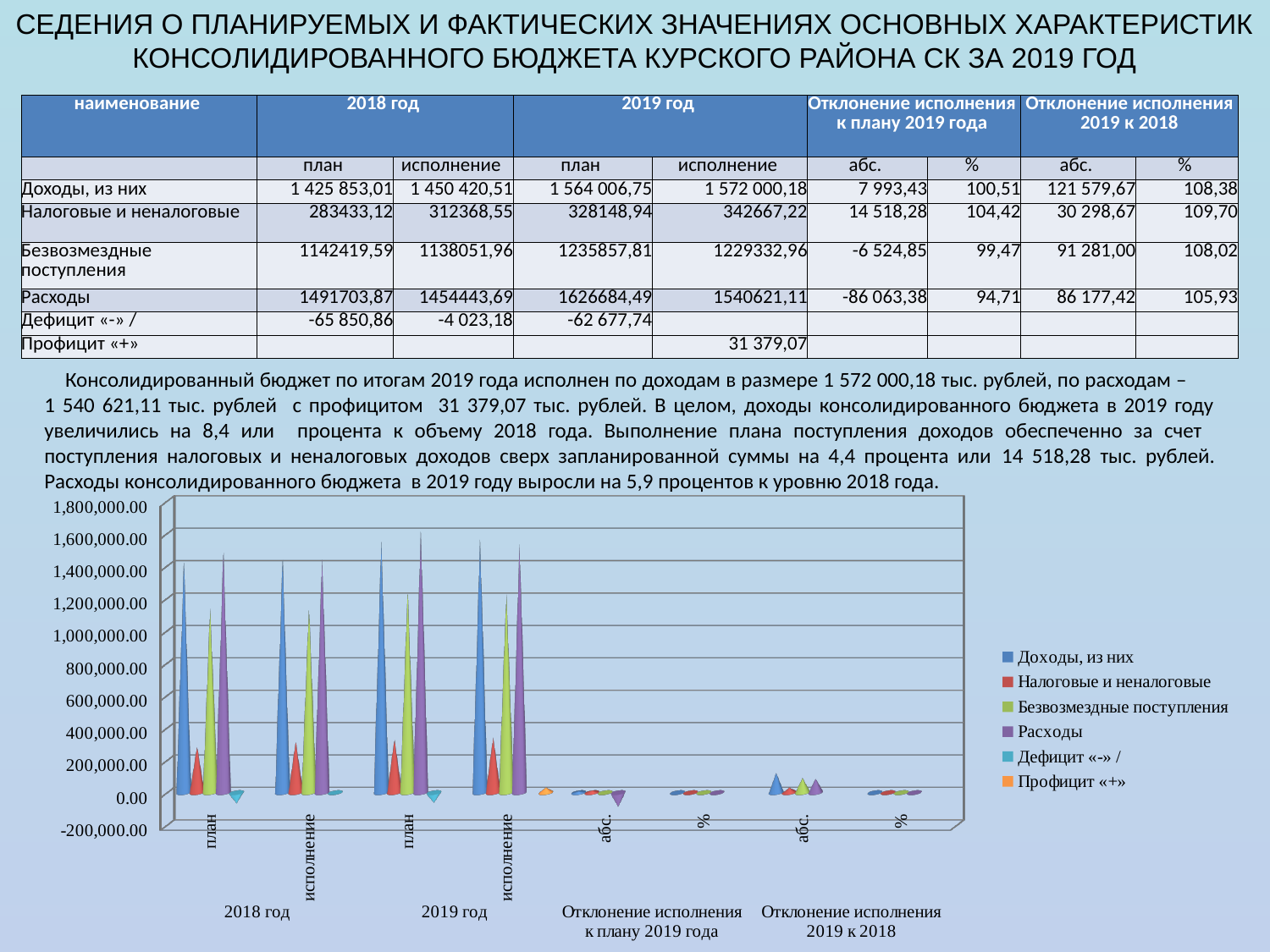
Is the value for Налоговые и неналоговые in the 2018 год план category greater or less than 400,000.00? less Which series has the lowest value in the 2018 год план category? Дефицит «-» / What kind of chart is shown at the bottom of the slide? bar chart What is the highest tick value shown on the chart's vertical axis? 1,800,000.00 In the 2019 год исполнение category, which is larger: Безвозмездные поступления or Налоговые и неналоговые? Безвозмездные поступления What colour represents the Расходы series in the chart legend? purple How many categories are shown along the x axis of the chart? 8 Is the value for Доходы, из них in the 2018 год план category greater or less than 1,200,000.00? greater Is the value for Дефицит «-» / in the 2018 год план category greater or less than 0.00? less How many series does the chart legend list? 6 What is the value of Доходы, из них for 2019 год исполнение, as given in the table above the chart? 1 572 000,18